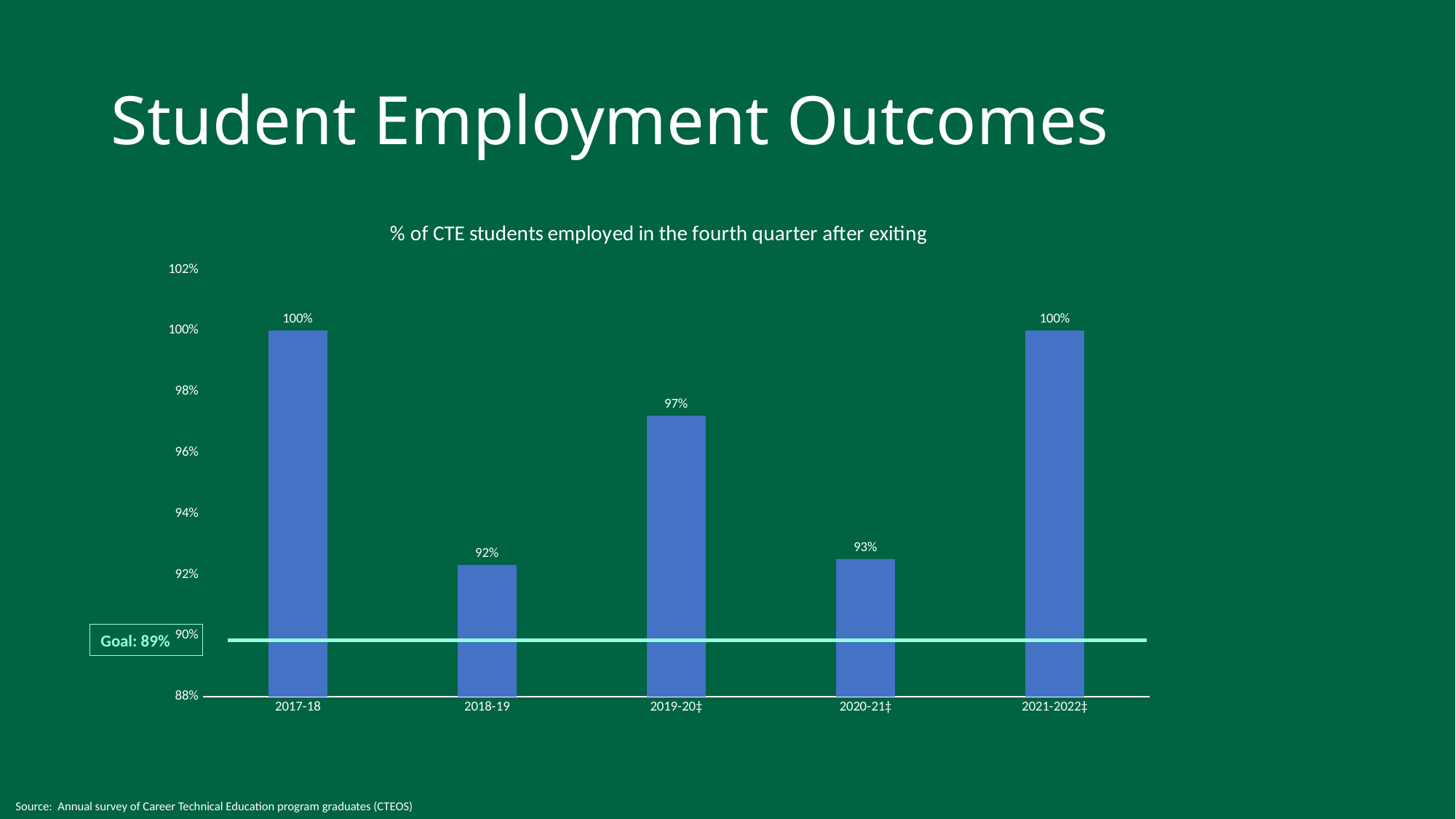
What is the goal value marked by the horizontal line on the chart? 89% What is the value for 2020-21‡? 93% Which is larger, the value for 2019-20‡ or the value for 2020-21‡? 2019-20‡ What is the title of the chart? % of CTE students employed in the fourth quarter after exiting What kind of chart is this? bar chart What is the difference between the values for 2021-2022‡ and 2020-21‡? 7% What is the value for 2019-20‡? 97% What is the value for 2017-18? 100% How many years are shown on the chart? 5 What is the difference between the values for 2019-20‡ and 2018-19? 5% Which year has the lowest percentage of CTE students employed? 2018-19 What is the value for 2018-19? 92%